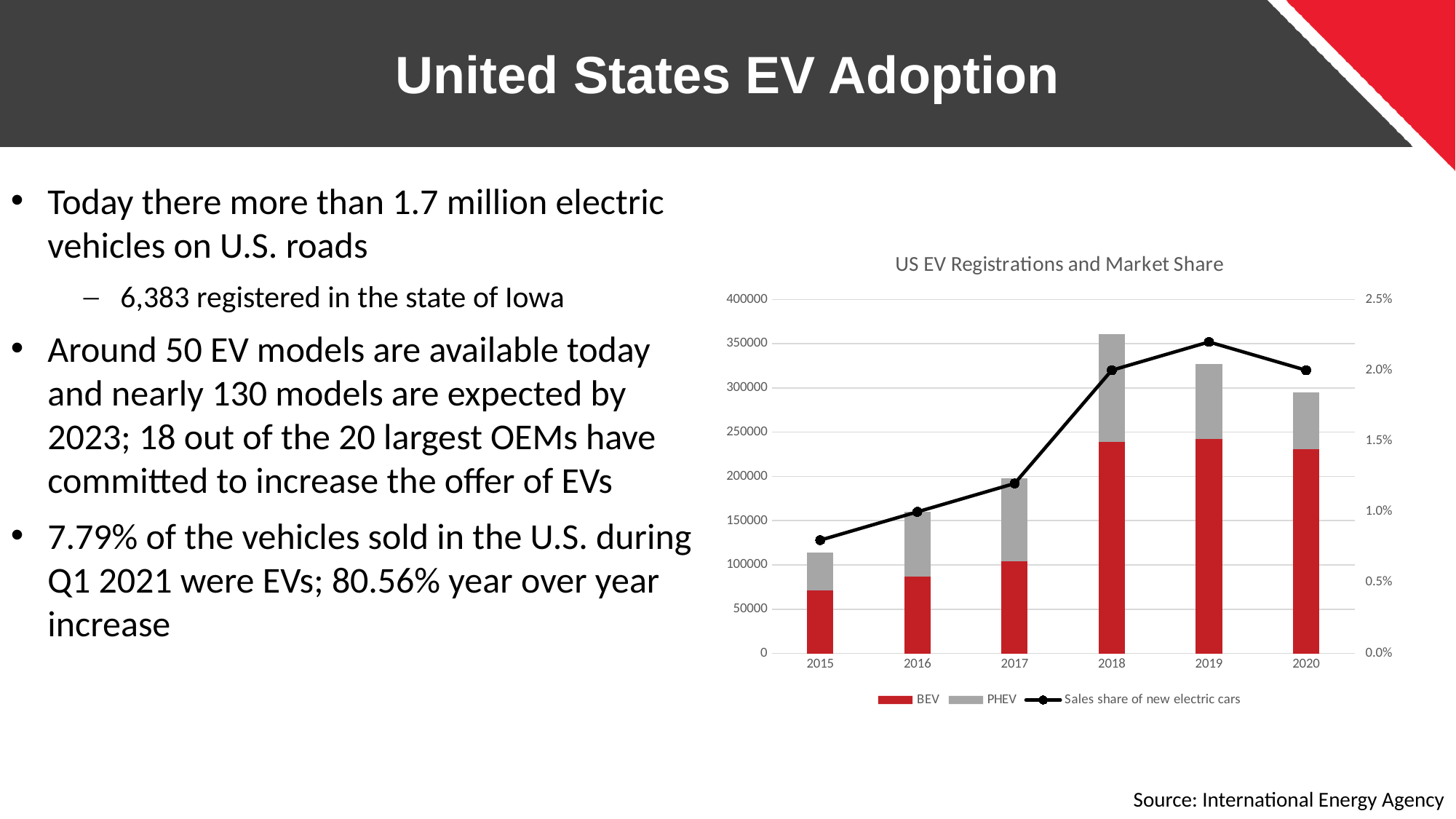
Which colour represents PHEV in the chart? Grey What is the title of the chart? US EV Registrations and Market Share What kind of chart is shown on the slide? A combined stacked bar and line chart Is the total registrations bar for 2015 greater or less than 150000? less In which year does the sales share of new electric cars line reach its highest point? 2019 How many series does the chart's legend list? 3 Is the sales share of new electric cars in 2015 greater or less than 1.0%? less Which year has the tallest stacked bar (highest total registrations)? 2018 Which year has the shortest stacked bar (lowest total registrations)? 2015 Is the total registrations bar for 2018 greater or less than 300000? greater Which year has the larger BEV registrations, 2017 or 2019? 2019 How many years are shown on the x axis of the chart? 6